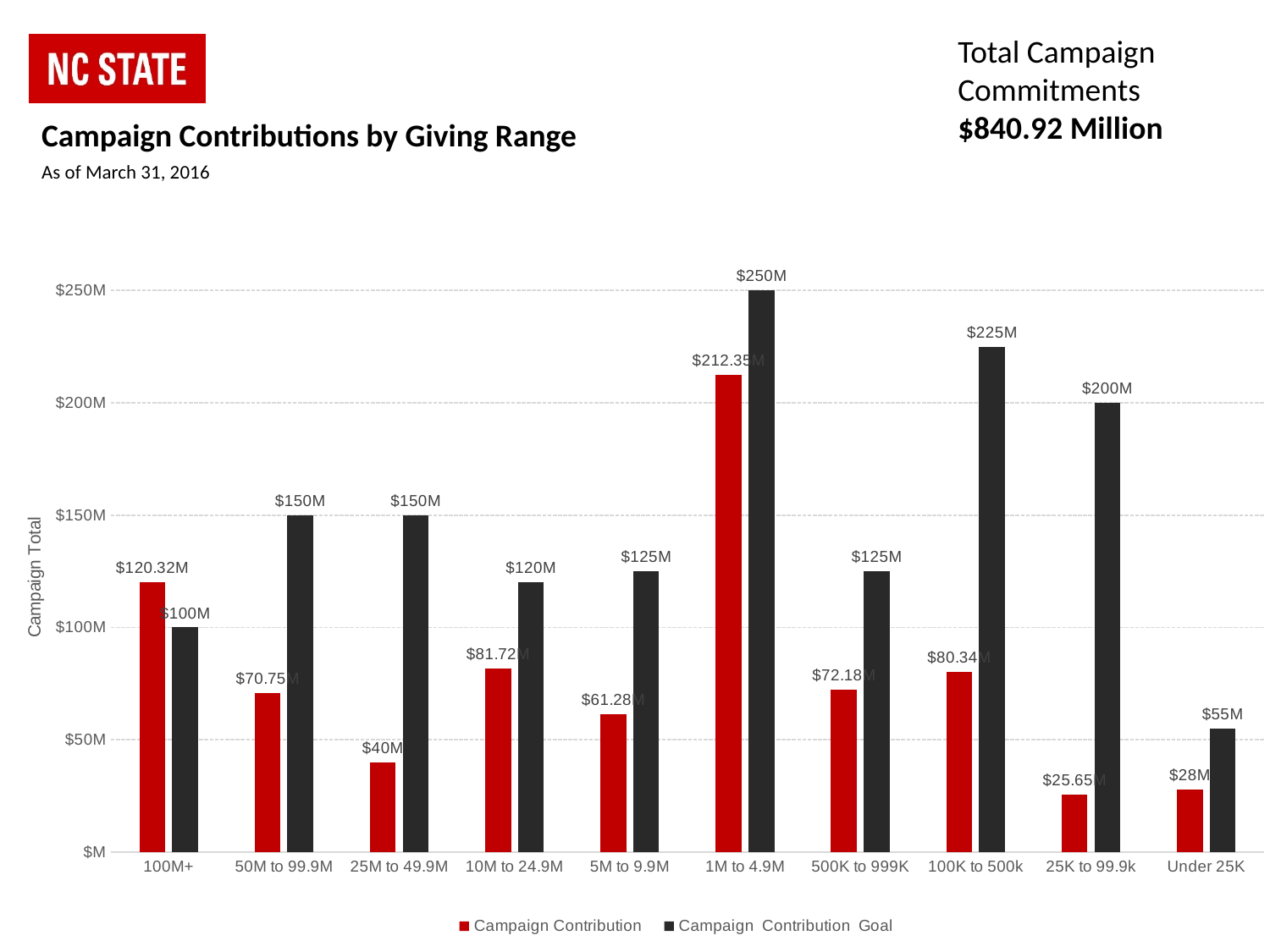
What kind of chart is shown on the slide? Bar chart What is the Campaign Contribution value for the 25M to 49.9M giving range? $40M What is the total campaign commitments figure stated on the slide? $840.92 Million How many series does the legend list? 2 What is the difference between the Campaign Contribution Goal and the Campaign Contribution for the 1M to 4.9M giving range? $37.65M How many giving ranges are shown on the x axis? 10 What is the Campaign Contribution value for the 1M to 4.9M giving range? $212.35M Which giving range has the lowest Campaign Contribution Goal? Under 25K What is the Campaign Contribution Goal for the 100K to 500k giving range? $225M Which giving range has the lowest Campaign Contribution? 25K to 99.9k Which giving range has the highest Campaign Contribution? 1M to 4.9M For the 100M+ giving range, which is larger: the Campaign Contribution or the Campaign Contribution Goal? Campaign Contribution